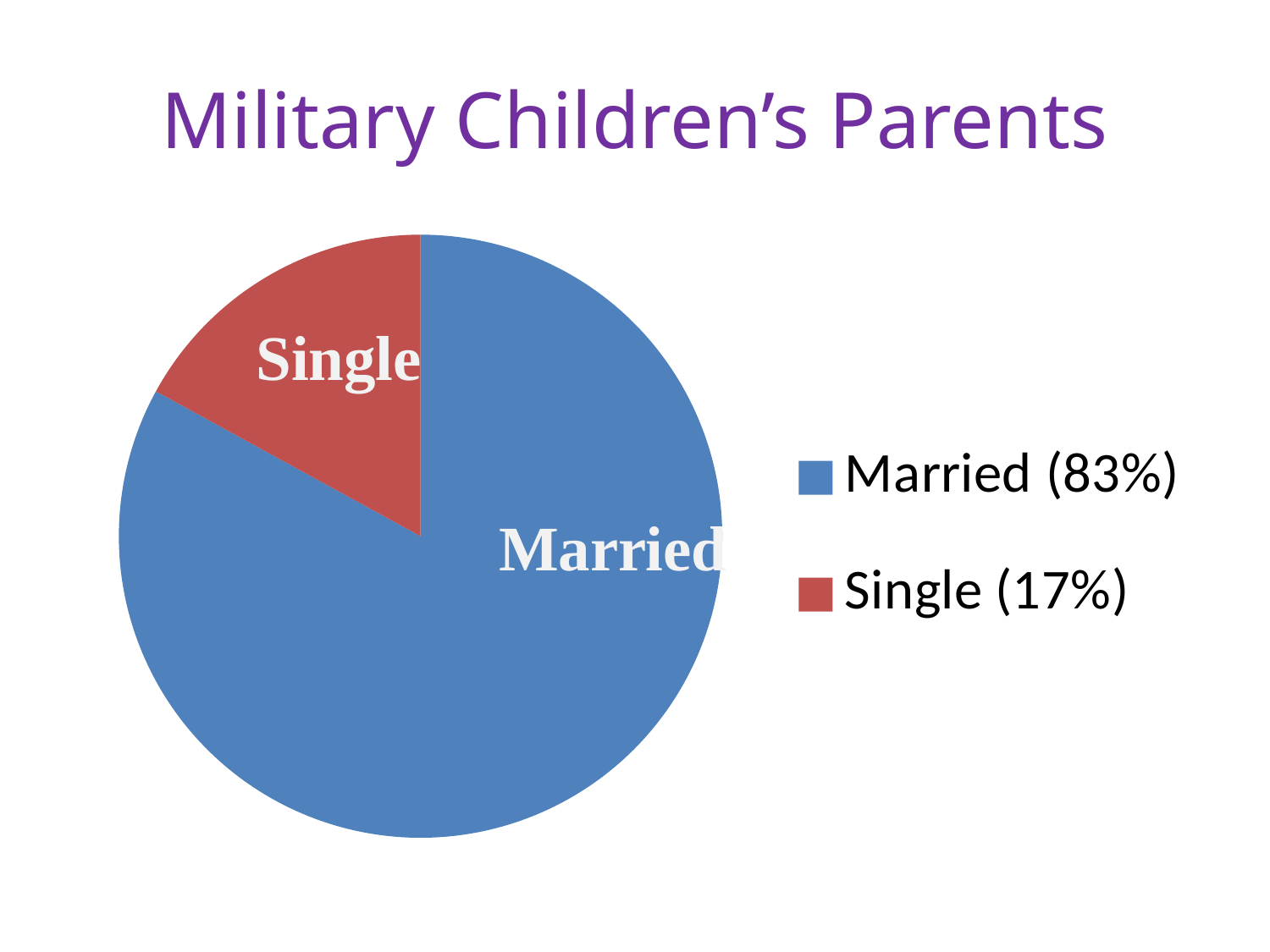
What share of the pie is Married? 83% What is the title of the slide? Military Children's Parents Which category has the largest slice of the pie? Married Which category has the smallest slice of the pie? Single Which is larger, the Married slice or the Single slice? Married What colour is the Single slice? red What is the difference in percentage points between the Married and Single shares? 66 How many slices does the pie chart have? 2 What kind of chart is shown on the slide? pie chart What share of the pie is Single? 17% How many entries does the legend list? 2